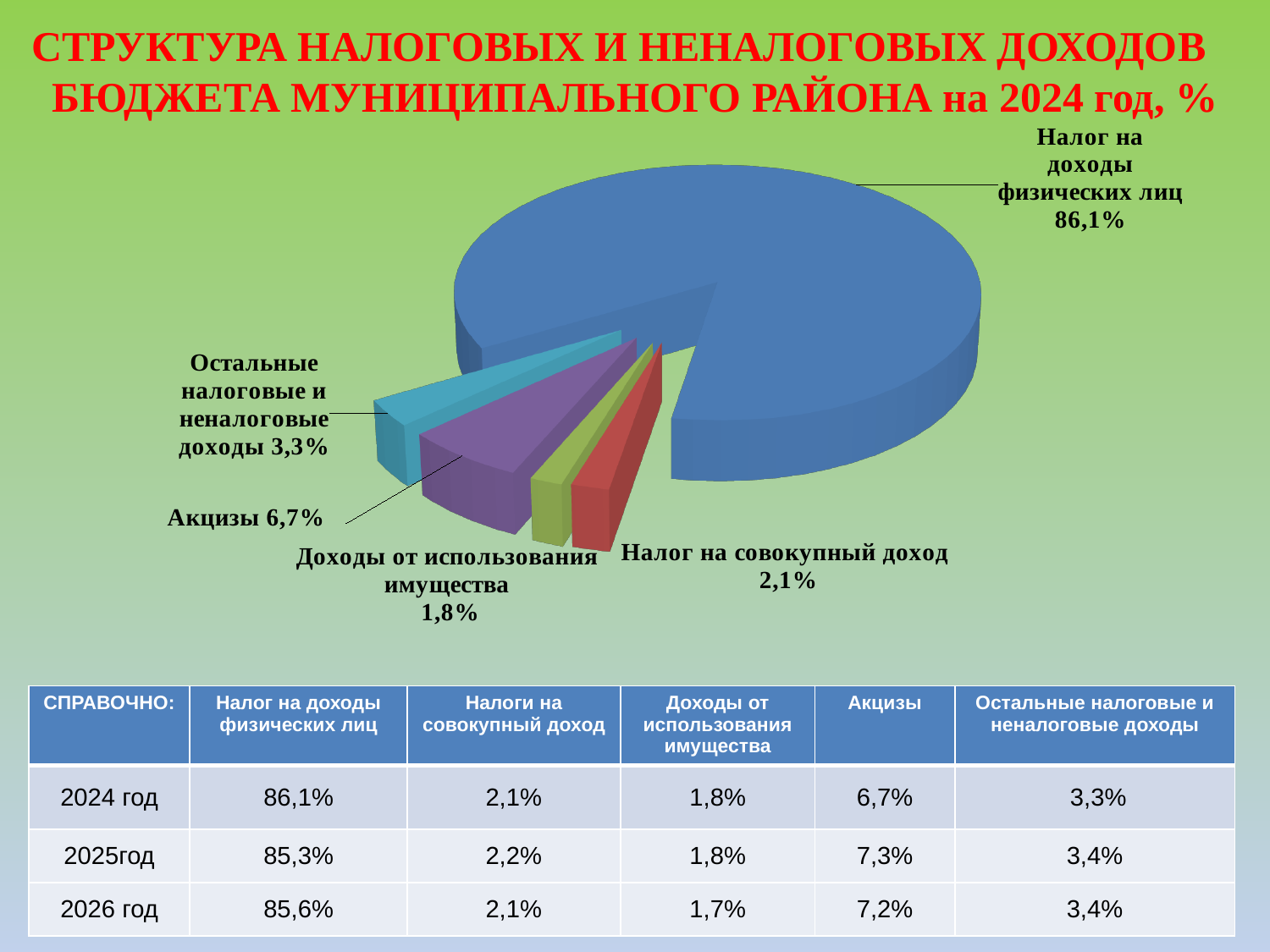
What colour is the slice for "Налог на доходы физических лиц"? Blue Which slice of the pie chart is the largest? Налог на доходы физических лиц What share of the pie does "Налог на доходы физических лиц" have? 86,1% How many slices does the pie chart have? 5 What is the value shown for "Доходы от использования имущества" on the pie chart? 1,8% What is the value shown for "Акцизы" on the pie chart? 6,7% What is the value shown for "Остальные налоговые и неналоговые доходы" on the pie chart? 3,3% Which is larger on the pie chart: "Налог на совокупный доход" or "Доходы от использования имущества"? Налог на совокупный доход What kind of chart is shown on the slide? Pie chart What is the value shown for "Налог на совокупный доход" on the pie chart? 2,1% What is the difference between the shares of "Акцизы" and "Остальные налоговые и неналоговые доходы"? 3,4% Which slice of the pie chart is the smallest? Доходы от использования имущества